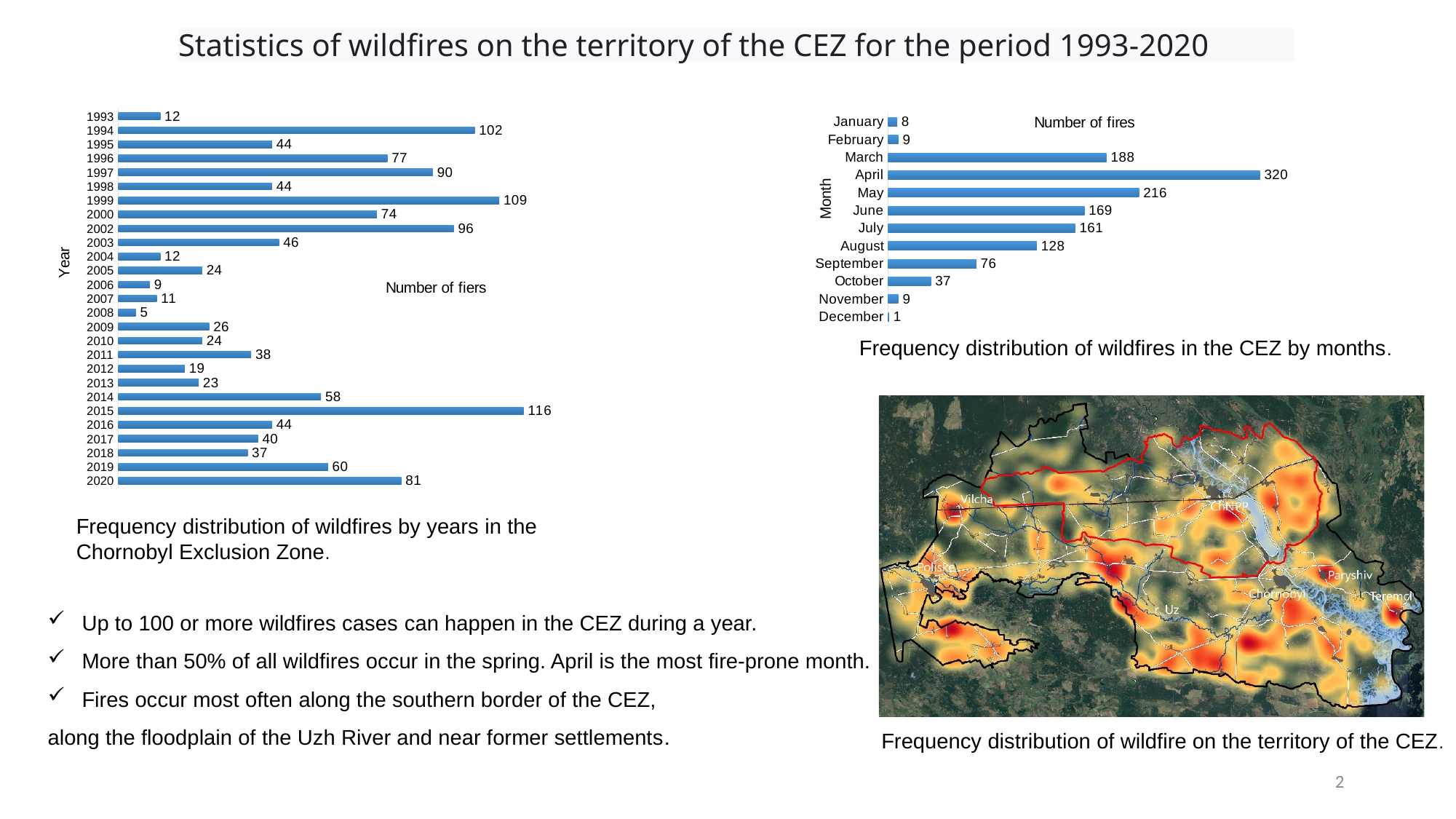
In the chart of wildfires by months, what is the label of the vertical axis? Month In the chart of wildfires by months, what is the difference between the number of fires in May and in June? 47 What type of chart is used to show the frequency distribution of wildfires by months? Bar chart In the chart of wildfires by months, which month has the lowest number of fires? December In the chart of wildfires by years, which year had more fires, 1994 or 2002? 1994 In the chart of wildfires by years, how many years are plotted? 27 In the chart of wildfires by years, what is the difference between the number of fires in 1999 and in 2000? 35 In the chart of wildfires by years, which year has the highest number of fires? 2015 In the chart of wildfires by years, which year has the lowest number of fires? 2008 In the chart of wildfires by years, how many fires were recorded in 2015? 116 In the chart of wildfires by months, how many fires were recorded in April? 320 In the chart of wildfires by months, which month had more fires, March or August? March